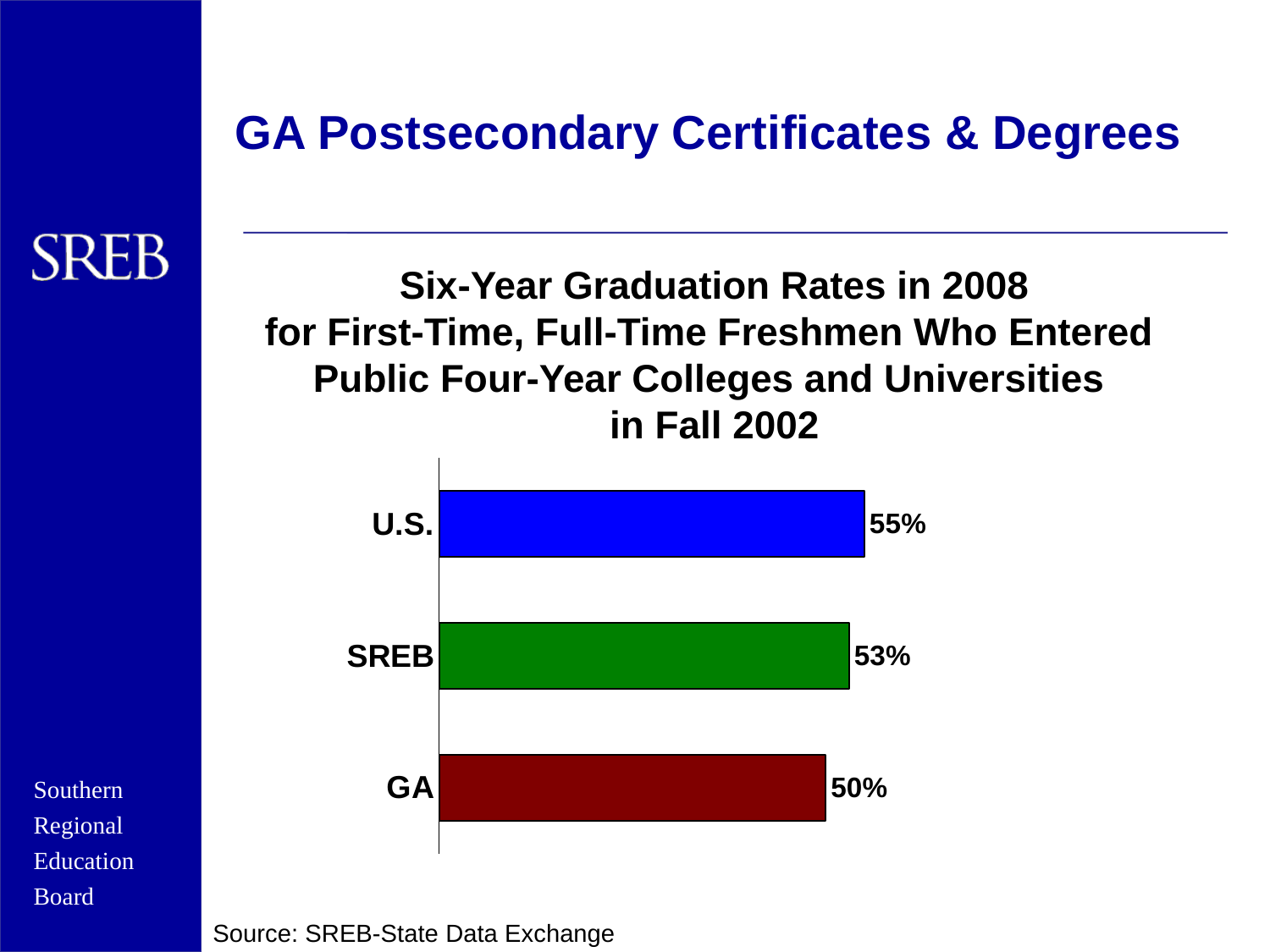
Which category has the lowest graduation rate? GA What kind of chart is shown on the slide? Bar chart What is the source cited for the chart data? SREB-State Data Exchange What is the six-year graduation rate shown for GA? 50% Which is larger, the graduation rate for SREB or for GA? SREB Which category has the highest graduation rate? U.S. What is the difference between the U.S. and GA graduation rates? 5% How many categories are shown in the chart? 3 What is the six-year graduation rate shown for SREB? 53% What is the difference between the SREB and GA graduation rates? 3% What is the six-year graduation rate shown for the U.S.? 55% What colour is the bar for GA? Dark red